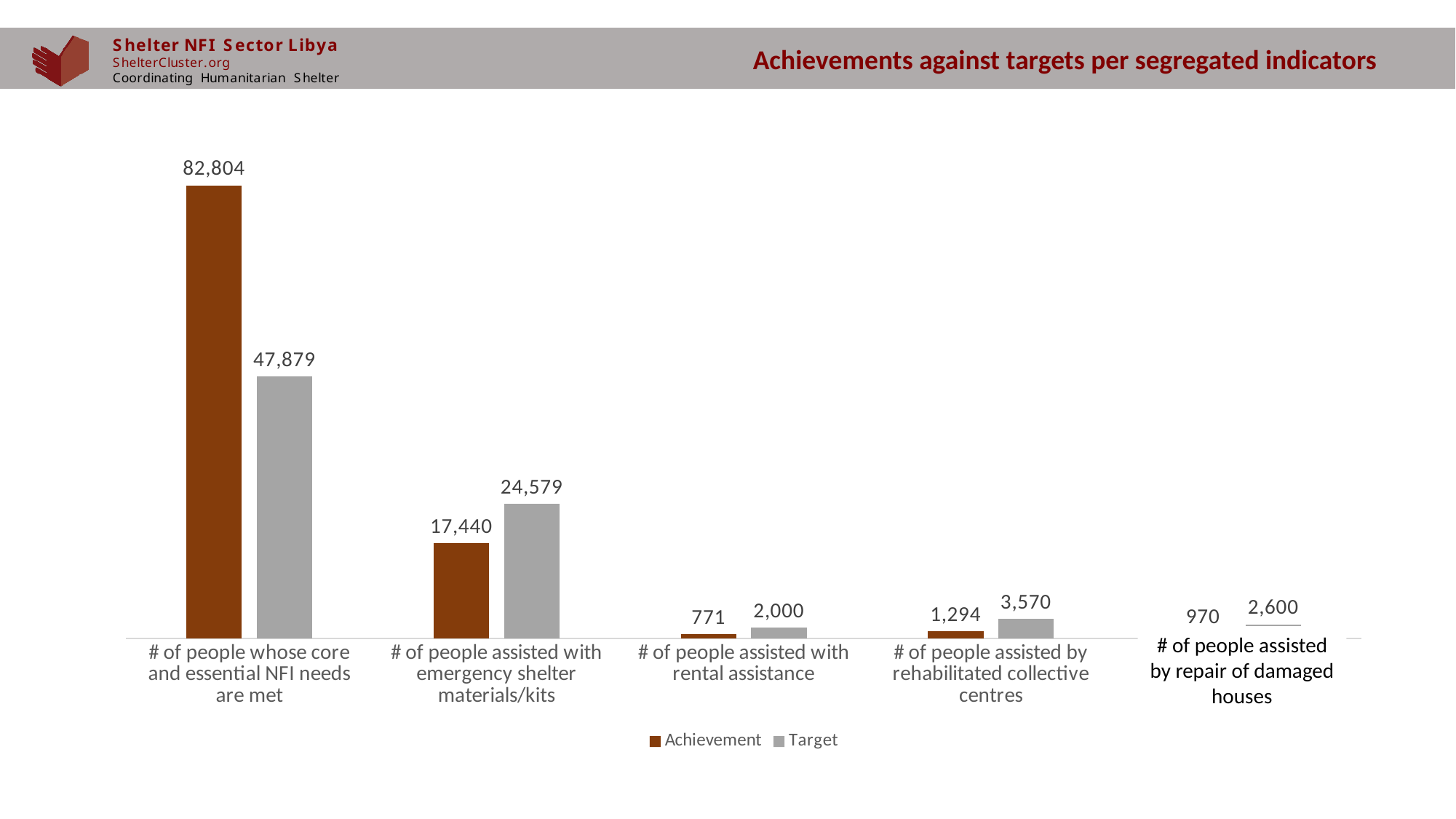
For '# of people assisted with emergency shelter materials/kits', which is larger, the Achievement or the Target? Target Which category has the lowest Target value? # of people assisted with rental assistance What is the Target value for '# of people assisted with emergency shelter materials/kits'? 24,579 What type of chart is shown on the slide? Bar chart How many categories are shown on the x axis? 5 What is the Achievement value for '# of people whose core and essential NFI needs are met'? 82,804 How many series does the legend list? 2 What is the difference between the Target and Achievement values for '# of people assisted by rehabilitated collective centres'? 2,276 What is the Achievement value for '# of people assisted with rental assistance'? 771 What is the difference between the Achievement and Target values for '# of people whose core and essential NFI needs are met'? 34,925 Which category has the highest Achievement value? # of people whose core and essential NFI needs are met What is the Target value for '# of people assisted by repair of damaged houses'? 2,600